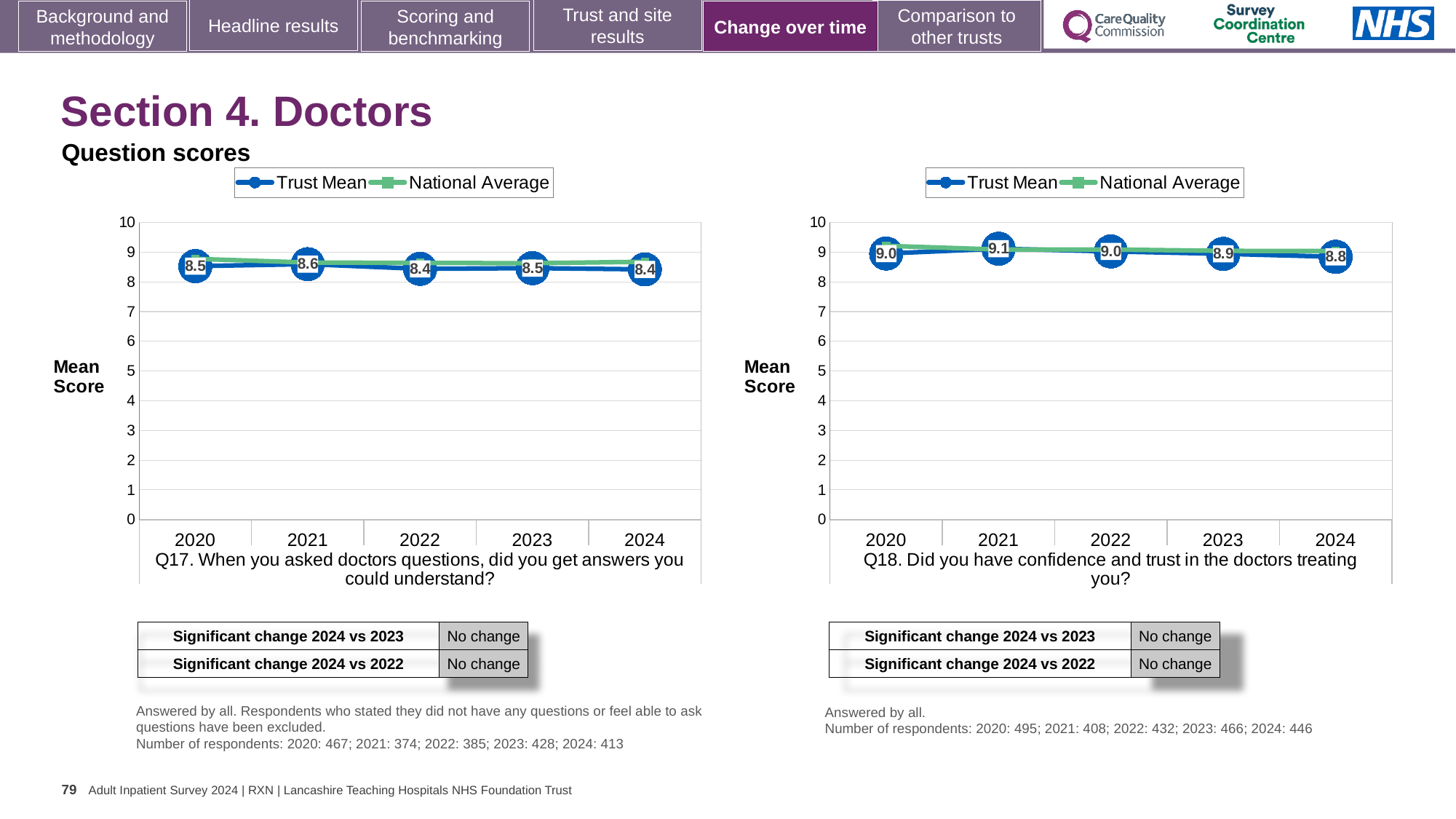
In the Q17 chart, is the National Average for 2020 greater or less than 8? greater In the Q17 chart, which year has the larger Trust Mean score, 2021 or 2022? 2021 In the Q18 chart, what is the Trust Mean score for 2024? 8.8 In the Q17 chart, what is the Trust Mean score for 2021? 8.6 In the Q17 chart, what is the Trust Mean score for 2022? 8.4 In the Q18 chart, which year has the highest Trust Mean score? 2021 How many years are plotted on the x axis of the Q18 chart? 5 How many series does the legend of the Q17 chart list? 2 In the Q18 chart, which year has the lowest Trust Mean score? 2024 In the Q18 chart, what is the difference between the Trust Mean scores for 2021 and 2024? 0.3 In the Q18 chart, does the Trust Mean rise or fall from 2021 to 2024? Fall What kind of chart is the Q18 chart? Line chart